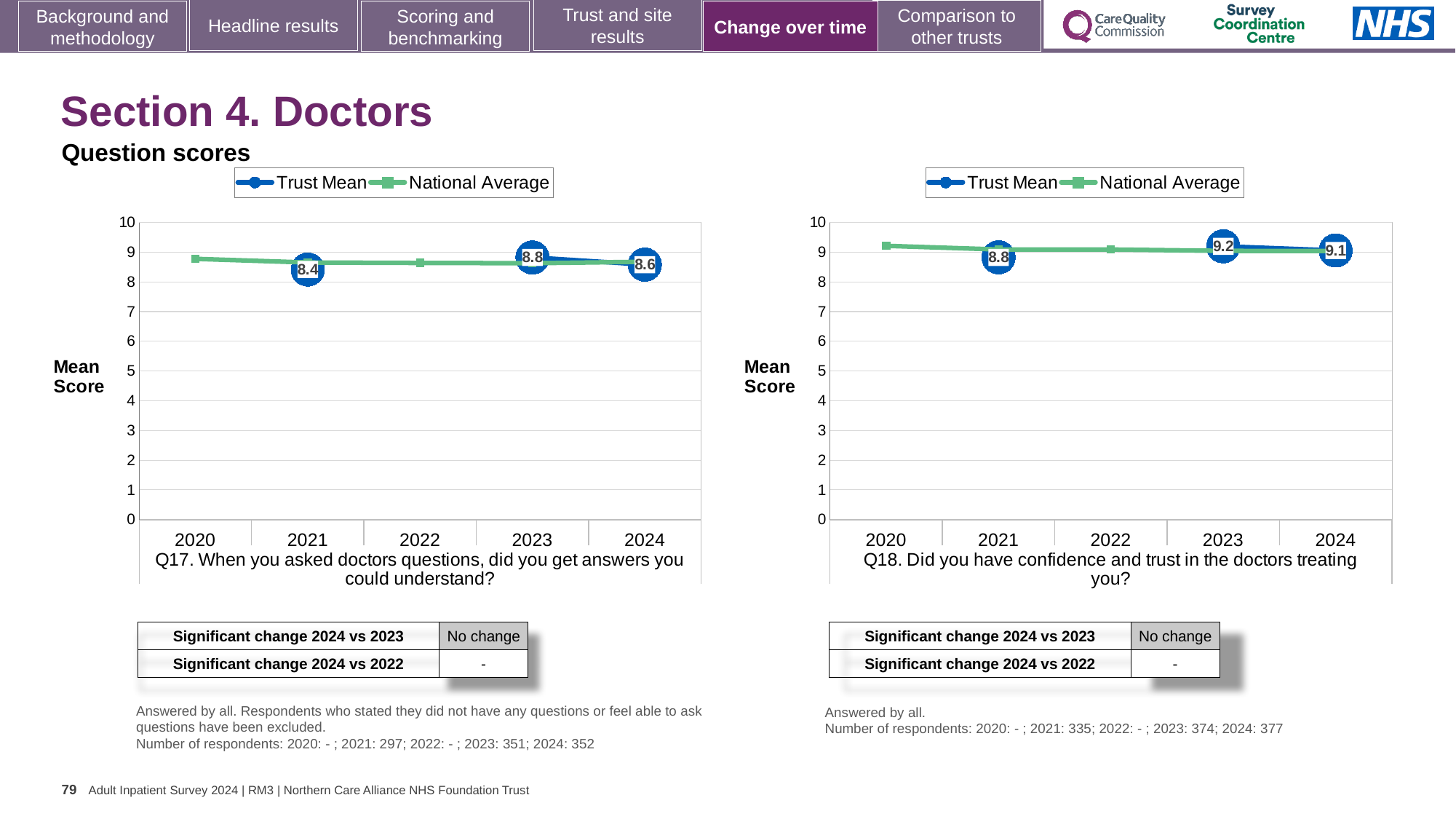
In the Q17 chart, which year has the highest Trust Mean score? 2023 In the Q17 chart, what is the Trust Mean score for 2021? 8.4 In the Q18 chart, which year has the lowest Trust Mean score? 2021 How many years are shown on the x axis of the Q17 chart? 5 What kind of chart is the Q18 chart? line chart In the Q18 chart, what is the Trust Mean score for 2023? 9.2 In the Q18 chart, is the Trust Mean score for 2023 larger or smaller than the score for 2021? larger In the Q18 chart, is the National Average value for 2020 greater or less than 8? greater In the Q17 chart, what is the difference between the Trust Mean scores for 2023 and 2021? 0.4 How many series does the legend of the Q17 chart list? 2 In the Q18 chart, what is the Trust Mean score for 2024? 9.1 In the Q17 chart, what is the Trust Mean score for 2024? 8.6